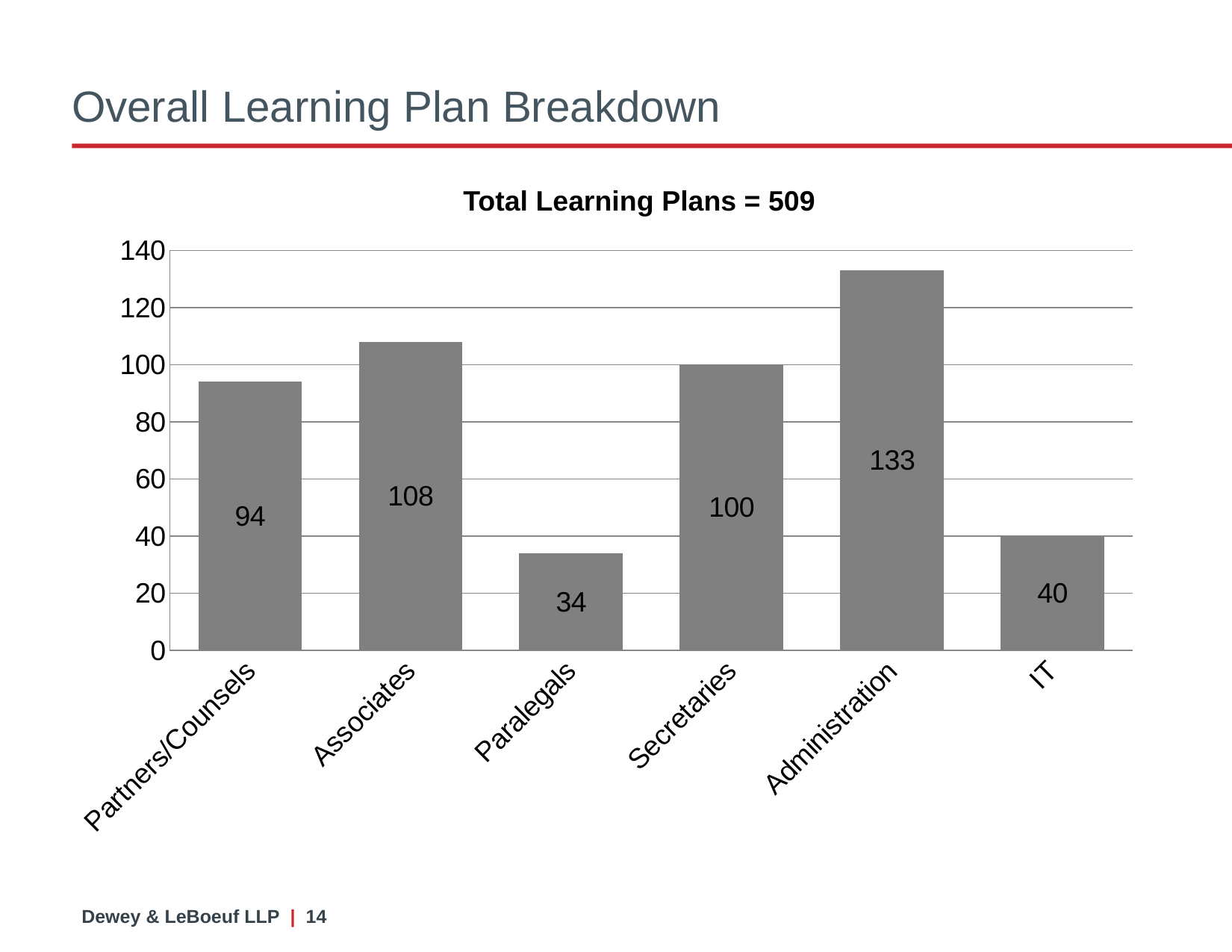
Is the value for Administration greater or less than 120? greater How many categories are shown on the x axis? 6 Which is larger, the value for Secretaries or the value for Partners/Counsels? Secretaries What is the title of the chart? Total Learning Plans = 509 What is the value for Associates? 108 What kind of chart is shown on the slide? bar chart What is the difference between the values for Administration and Partners/Counsels? 39 What is the value for Paralegals? 34 What is the difference between the values for Associates and IT? 68 What is the value for IT? 40 Which category has the highest value? Administration Which category has the lowest value? Paralegals